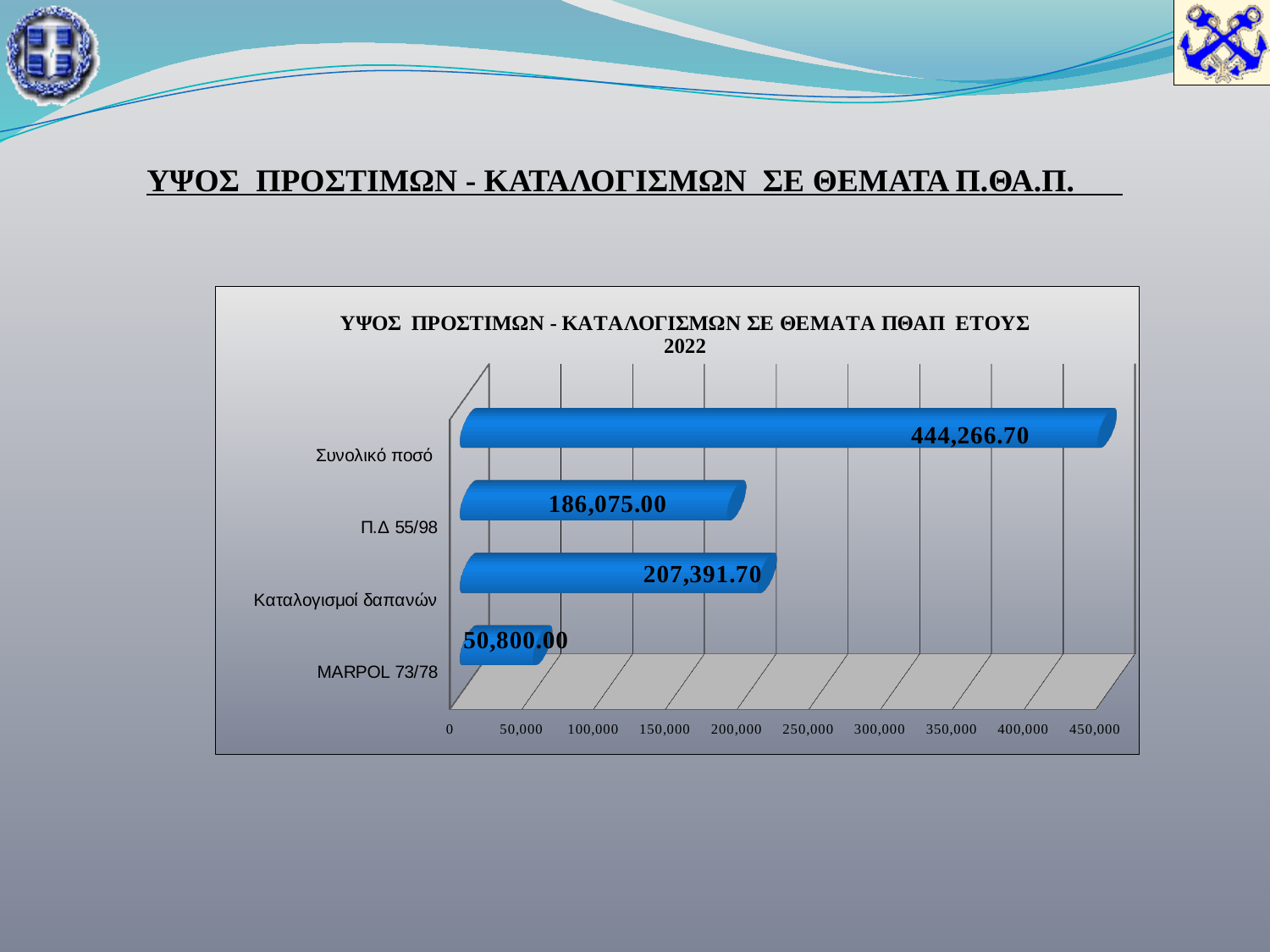
Which is larger, the value for Π.Δ 55/98 or the value for Καταλογισμοί δαπανών? Καταλογισμοί δαπανών What kind of chart is shown on the slide? bar chart Which category has the lowest value? MARPOL 73/78 What is the value for Καταλογισμοί δαπανών? 207,391.70 How many categories are shown in the chart? 4 What is the value for MARPOL 73/78? 50,800.00 What is the value for Συνολικό ποσό? 444,266.70 What is the value for Π.Δ 55/98? 186,075.00 What is the difference between the values for Καταλογισμοί δαπανών and Π.Δ 55/98? 21,316.70 Which category has the highest value? Συνολικό ποσό Is the value for Π.Δ 55/98 greater or less than 200,000? less What year does the chart title refer to? 2022